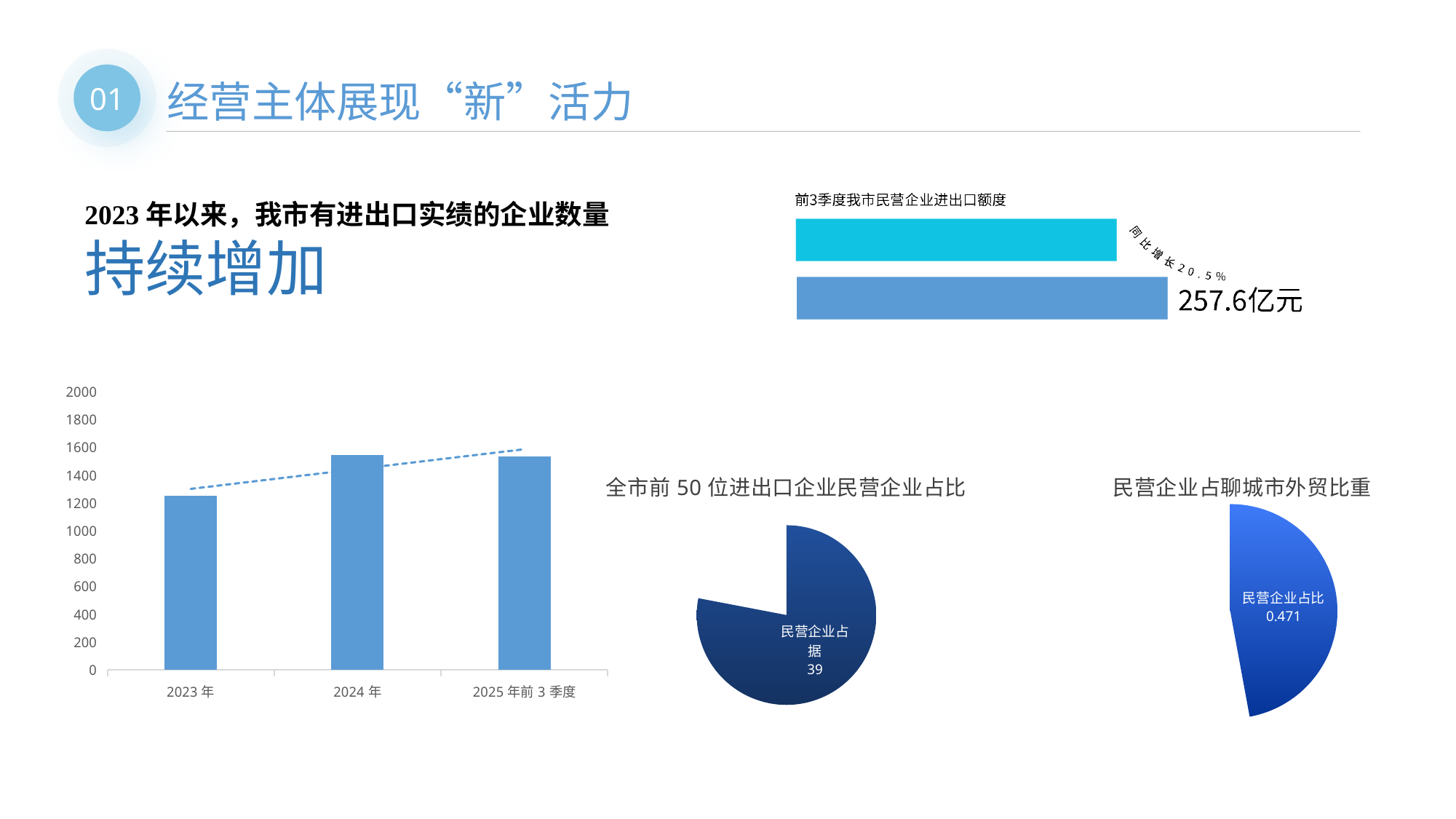
In the chart titled 前3季度我市民营企业进出口额度, what year-on-year growth rate is printed? 20.5% In the chart titled 前3季度我市民营企业进出口额度 at the top right, what value is printed next to the lower bar? 257.6亿元 In the pie chart titled 民营企业占聊城市外贸比重, what value is printed on the 民营企业占比 slice? 0.471 In the bar chart at the bottom left, is the value for 2025 年前 3 季度 greater or less than 1200? greater In the bar chart at the bottom left, is the value for 2024 年 greater or less than 1400? greater In the bar chart at the bottom left, how many categories are shown on the x axis? 3 What kind of chart is the chart at the bottom left of the slide showing 2023 年, 2024 年 and 2025 年前 3 季度? bar chart In the pie chart titled 全市前 50 位进出口企业民营企业占比, what value is printed on the 民营企业占据 slice? 39 In the bar chart at the bottom left, which category has the lowest value? 2023 年 In the bar chart at the bottom left, is the value for 2023 年 greater or less than 1400? less In the bar chart at the bottom left, does the value rise or fall from 2023 年 to 2024 年? rise In the bar chart at the bottom left, which is larger, the value for 2023 年 or the value for 2024 年? 2024 年